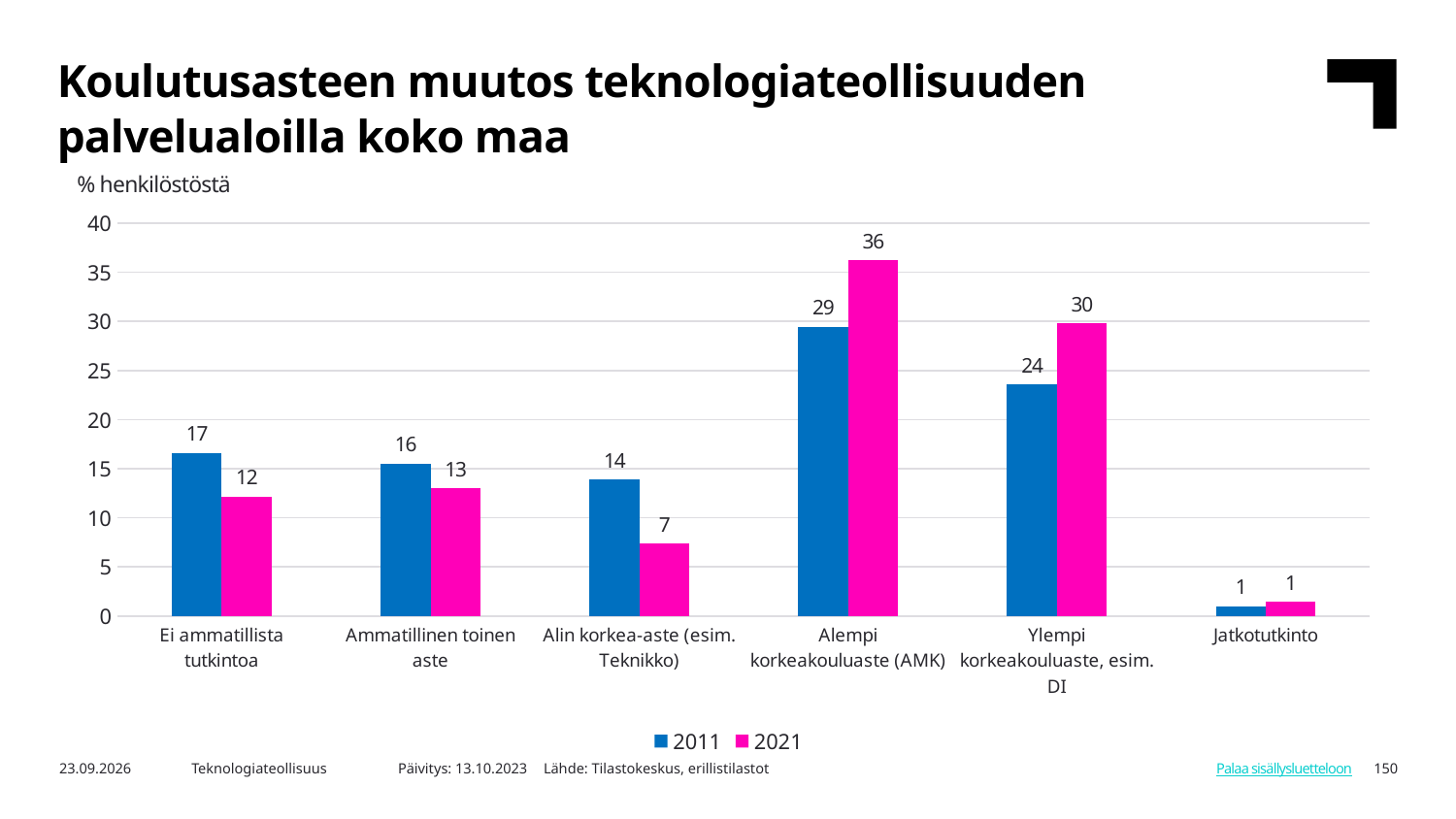
What is the difference between the 2021 and 2011 values for Alempi korkeakouluaste (AMK)? 7 What is the 2021 value for Alempi korkeakouluaste (AMK)? 36 How many categories are shown on the x axis? 6 Which is larger for Ei ammatillista tutkintoa, the 2011 value or the 2021 value? 2011 How many series does the legend list? 2 What unit is indicated above the chart for the values? % henkilöstöstä Is the 2021 value for Ylempi korkeakouluaste, esim. DI greater or less than 25? greater What kind of chart is shown on the slide? bar chart What is the 2021 value for Alin korkea-aste (esim. Teknikko)? 7 Which category has the lowest 2011 value? Jatkotutkinto Which category has the highest 2021 value? Alempi korkeakouluaste (AMK) What is the 2011 value for Ylempi korkeakouluaste, esim. DI? 24